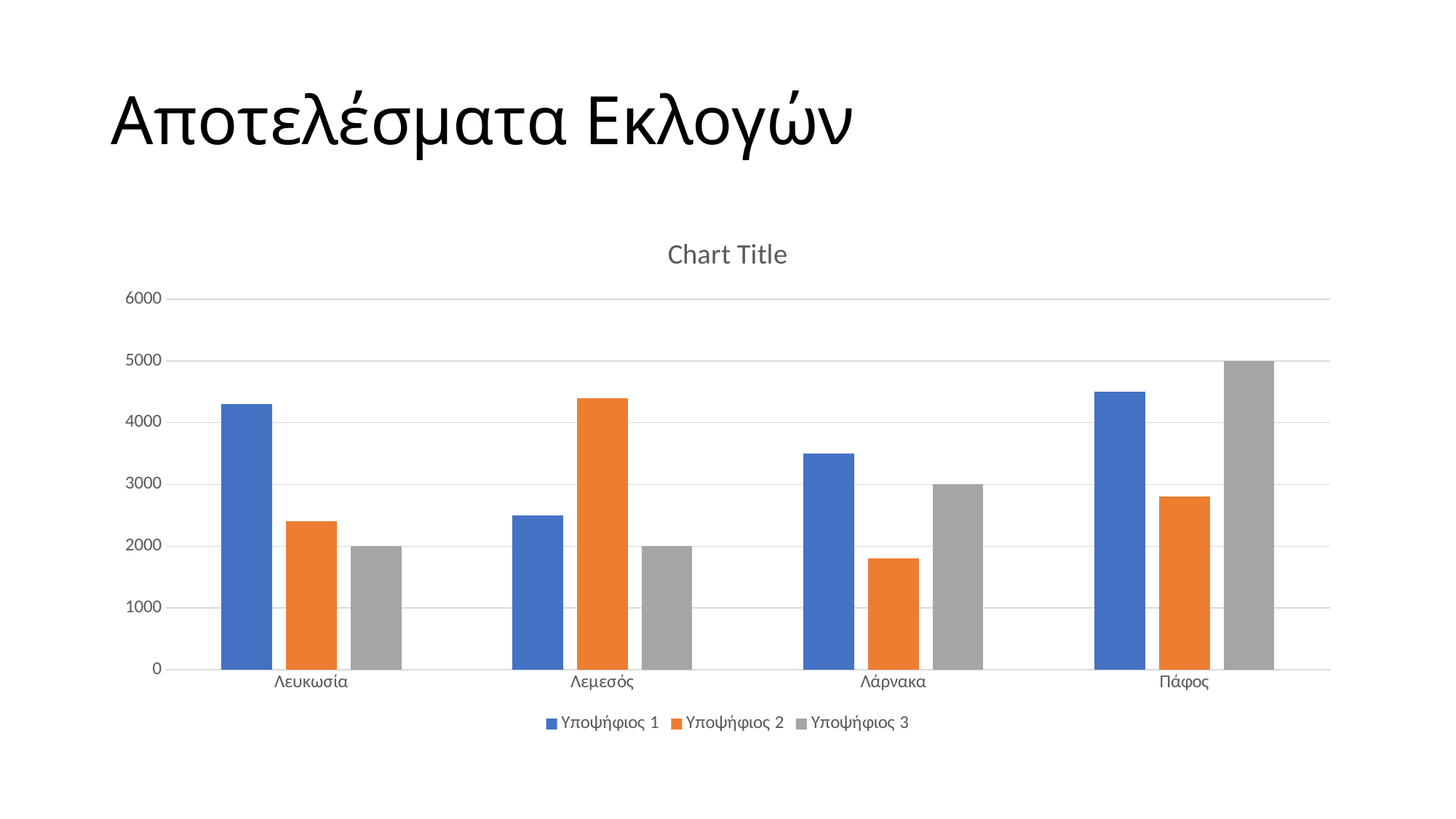
Which is larger in Λεμεσός: the value for Υποψήφιος 1 or Υποψήφιος 2? Υποψήφιος 2 What kind of chart is shown on the slide? bar chart Is the value for Υποψήφιος 2 in Λάρνακα greater or less than 2000? less What is the value for Υποψήφιος 3 in Λάρνακα? 3000 In which category does Υποψήφιος 2 have its lowest value? Λάρνακα What is the value for Υποψήφιος 3 in Πάφος? 5000 Is the value for Υποψήφιος 1 in Λεμεσός greater or less than 3000? less Is the value for Υποψήφιος 1 in Λευκωσία greater or less than 4000? greater How many categories are shown on the x axis? 4 How many series does the legend list? 3 In which category does Υποψήφιος 3 have its highest value? Πάφος What is the value for Υποψήφιος 3 in Λευκωσία? 2000